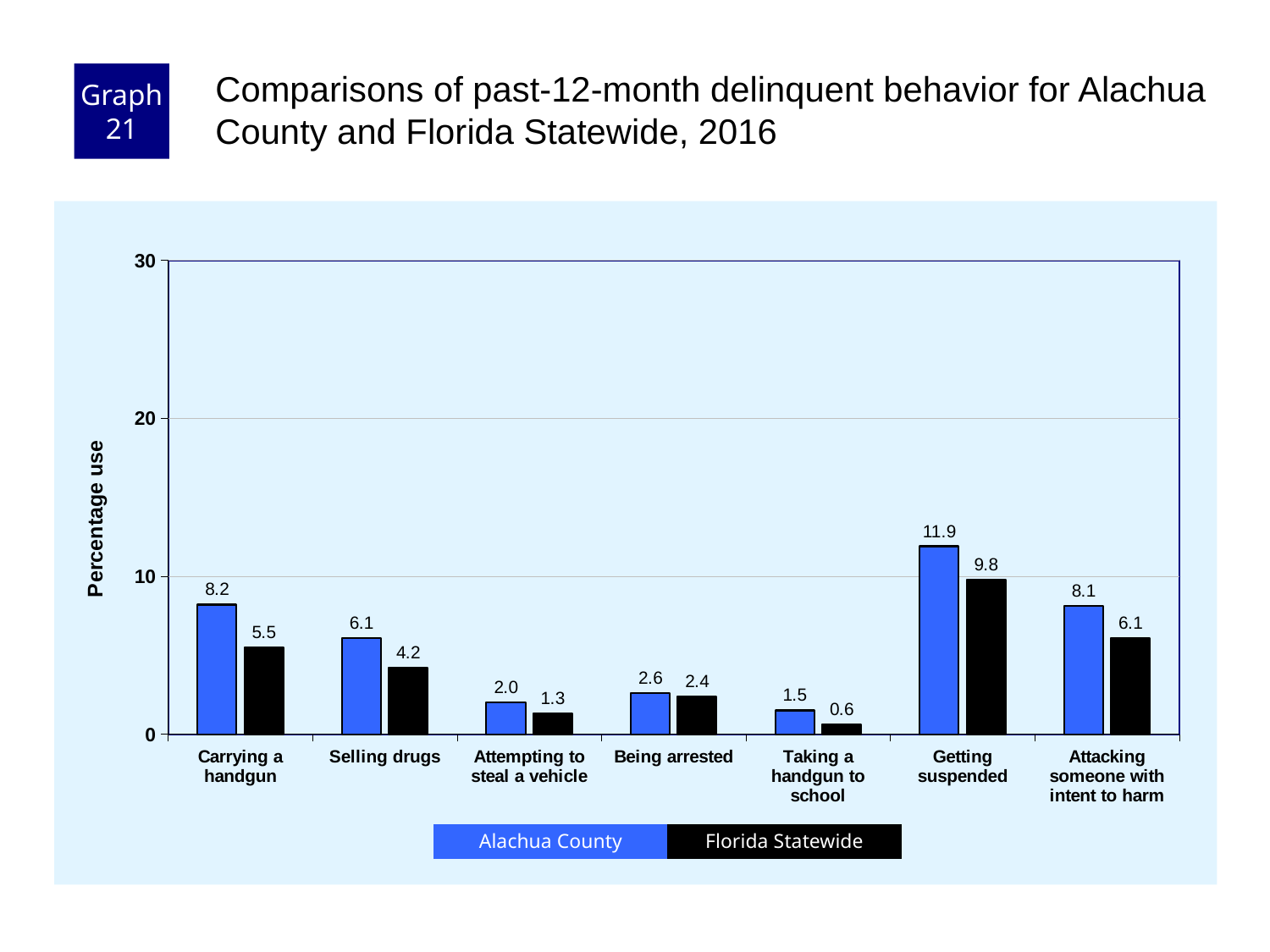
What kind of chart is shown on the slide? Bar chart How many series does the legend list? 2 What is the Alachua County value for Carrying a handgun? 8.2 What is the Florida Statewide value for Taking a handgun to school? 0.6 Which category has the lowest Florida Statewide value? Taking a handgun to school Which category has the highest Alachua County value? Getting suspended How many categories are shown on the x axis? 7 Which is larger for Carrying a handgun: the Alachua County value or the Florida Statewide value? Alachua County What is the difference between the Alachua County and Florida Statewide values for Selling drugs? 1.9 Is the Alachua County value for Getting suspended greater or less than 10? greater What is the Florida Statewide value for Getting suspended? 9.8 What is the difference between the Alachua County and Florida Statewide values for Attacking someone with intent to harm? 2.0